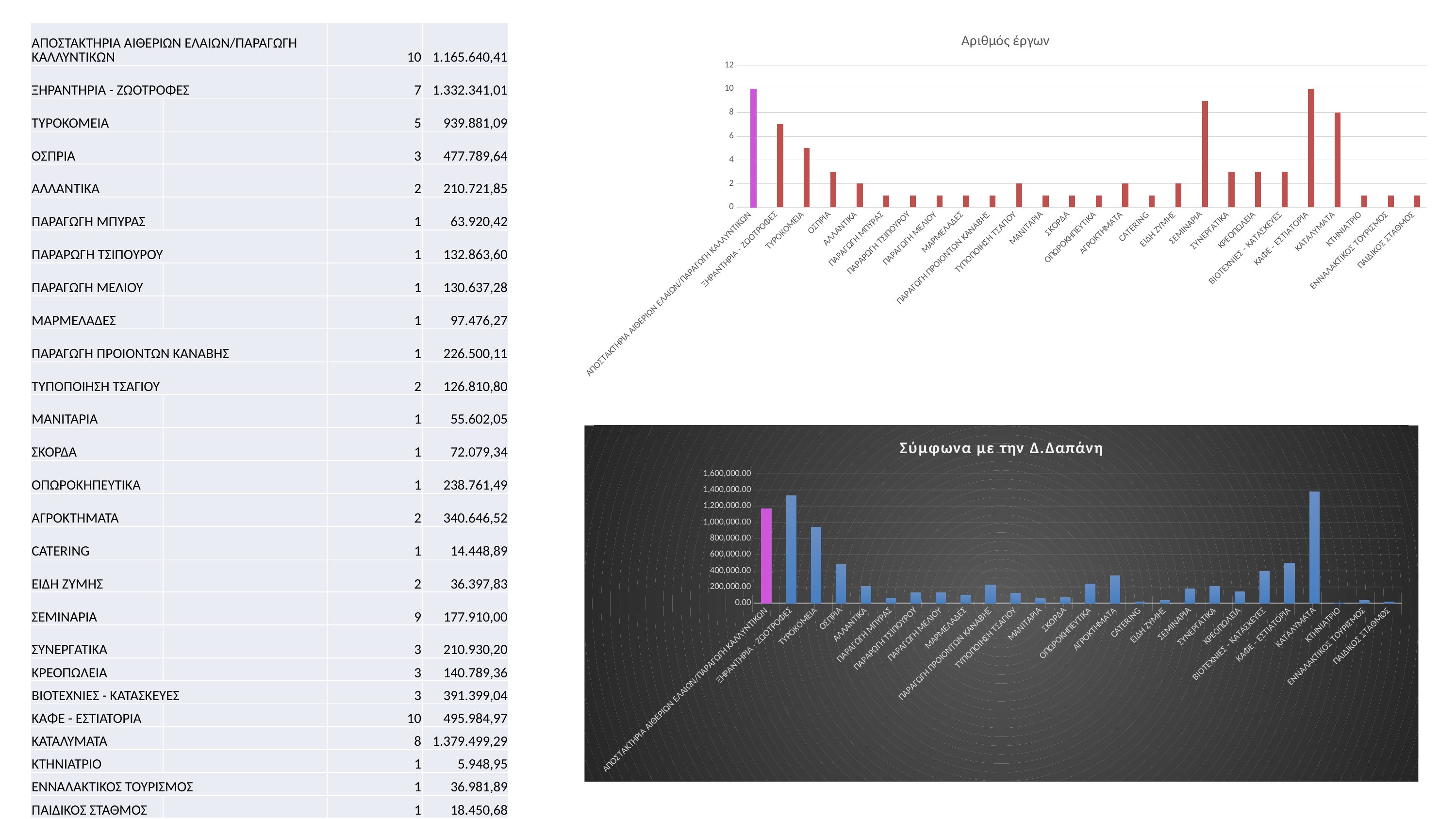
In the 'Αριθμός έργων' chart, which is larger, ΣΕΜΙΝΑΡΙΑ or ΣΥΝΕΡΓΑΤΙΚΑ? ΣΕΜΙΝΑΡΙΑ In the 'Σύμφωνα με την Δ.Δαπάνη' chart, is the value for ΑΓΡΟΚΤΗΜΑΤΑ greater or less than 400,000.00? less What type of chart is the 'Αριθμός έργων' chart? bar chart How many categories are shown on the x axis of the 'Αριθμός έργων' chart? 26 In the 'Αριθμός έργων' chart, is the value for ΣΕΜΙΝΑΡΙΑ greater or less than 8? greater In the 'Σύμφωνα με την Δ.Δαπάνη' chart, is the value for ΚΑΤΑΛΥΜΑΤΑ greater or less than 1,200,000.00? greater What is the title of the chart at the bottom right of the slide? Σύμφωνα με την Δ.Δαπάνη In the 'Σύμφωνα με την Δ.Δαπάνη' chart, which is larger, ΤΥΡΟΚΟΜΕΙΑ or ΟΣΠΡΙΑ? ΤΥΡΟΚΟΜΕΙΑ In the 'Αριθμός έργων' chart, what is the value for ΑΛΛΑΝΤΙΚΑ? 2 In the 'Αριθμός έργων' chart, what is the difference between the values for ΑΠΟΣΤΑΚΤΗΡΙΑ ΑΙΘΕΡΙΩΝ ΕΛΑΙΩΝ/ΠΑΡΑΓΩΓΗ ΚΑΛΛΥΝΤΙΚΩΝ and ΚΑΤΑΛΥΜΑΤΑ? 2 In the 'Αριθμός έργων' chart, what is the value for ΚΑΤΑΛΥΜΑΤΑ? 8 In the 'Αριθμός έργων' chart, what is the value for ΑΠΟΣΤΑΚΤΗΡΙΑ ΑΙΘΕΡΙΩΝ ΕΛΑΙΩΝ/ΠΑΡΑΓΩΓΗ ΚΑΛΛΥΝΤΙΚΩΝ? 10